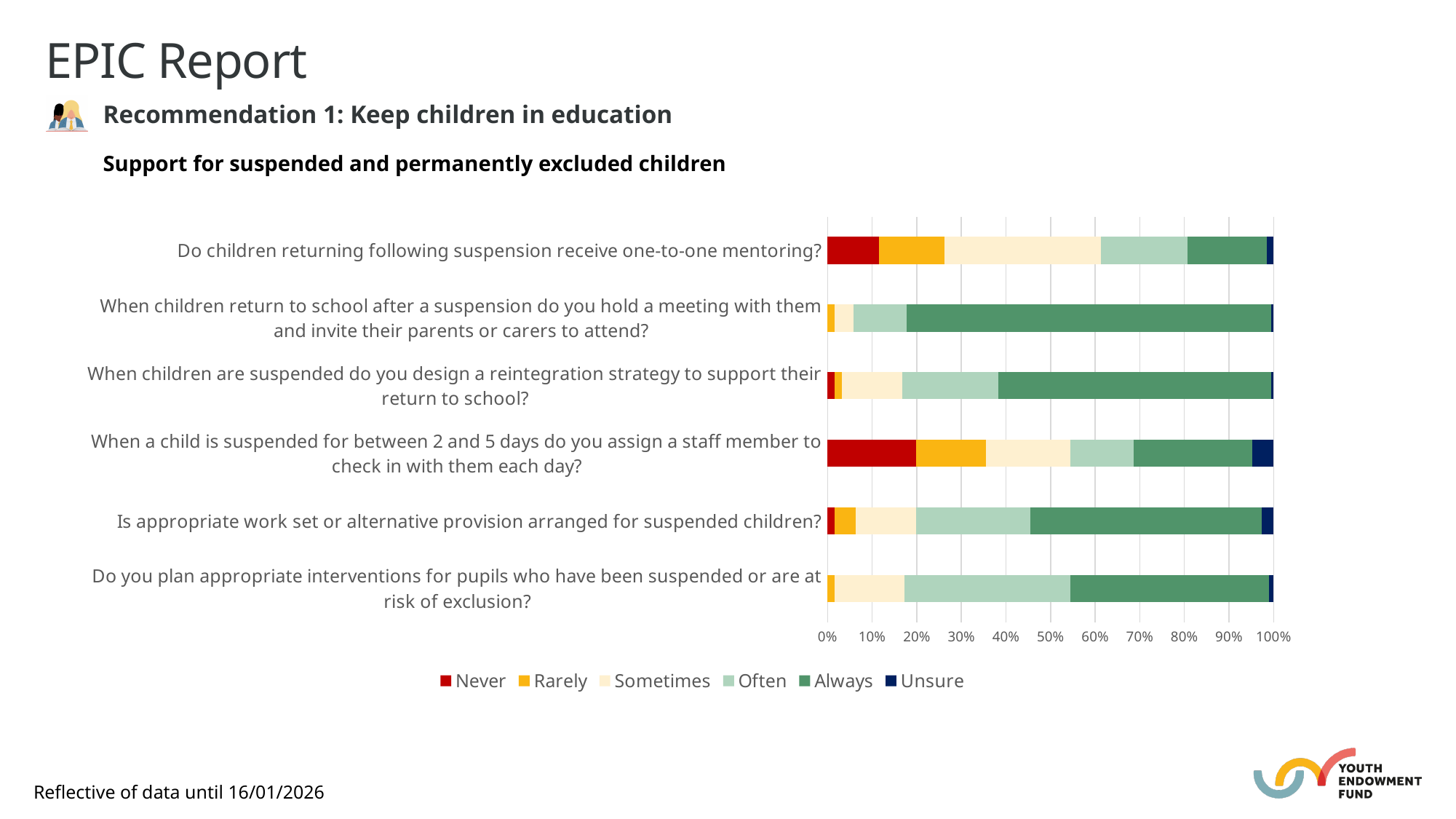
Which question has the largest 'Never' share? When a child is suspended for between 2 and 5 days do you assign a staff member to check in with them each day? Which has the larger 'Never' share: the one-to-one mentoring question or the question about assigning a staff member to check in each day? The question about assigning a staff member to check in each day What is the title of the chart? Support for suspended and permanently excluded children Is the 'Never' share for the question about assigning a staff member to check in each day greater or less than 30%? less What kind of chart is shown on the slide? Stacked bar chart Is the 'Always' share for the question about designing a reintegration strategy greater or less than 50%? greater How many questions (categories) are plotted on the chart? 6 Which question has the largest 'Always' share? When children return to school after a suspension do you hold a meeting with them and invite their parents or carers to attend? Is the 'Always' share for the question about holding a meeting with returning children and their parents or carers greater or less than 70%? greater Which question has the smallest 'Always' share? Do children returning following suspension receive one-to-one mentoring? Which has the larger 'Sometimes' share: the one-to-one mentoring question or the question about assigning a staff member to check in each day? The one-to-one mentoring question How many series does the chart legend list? 6